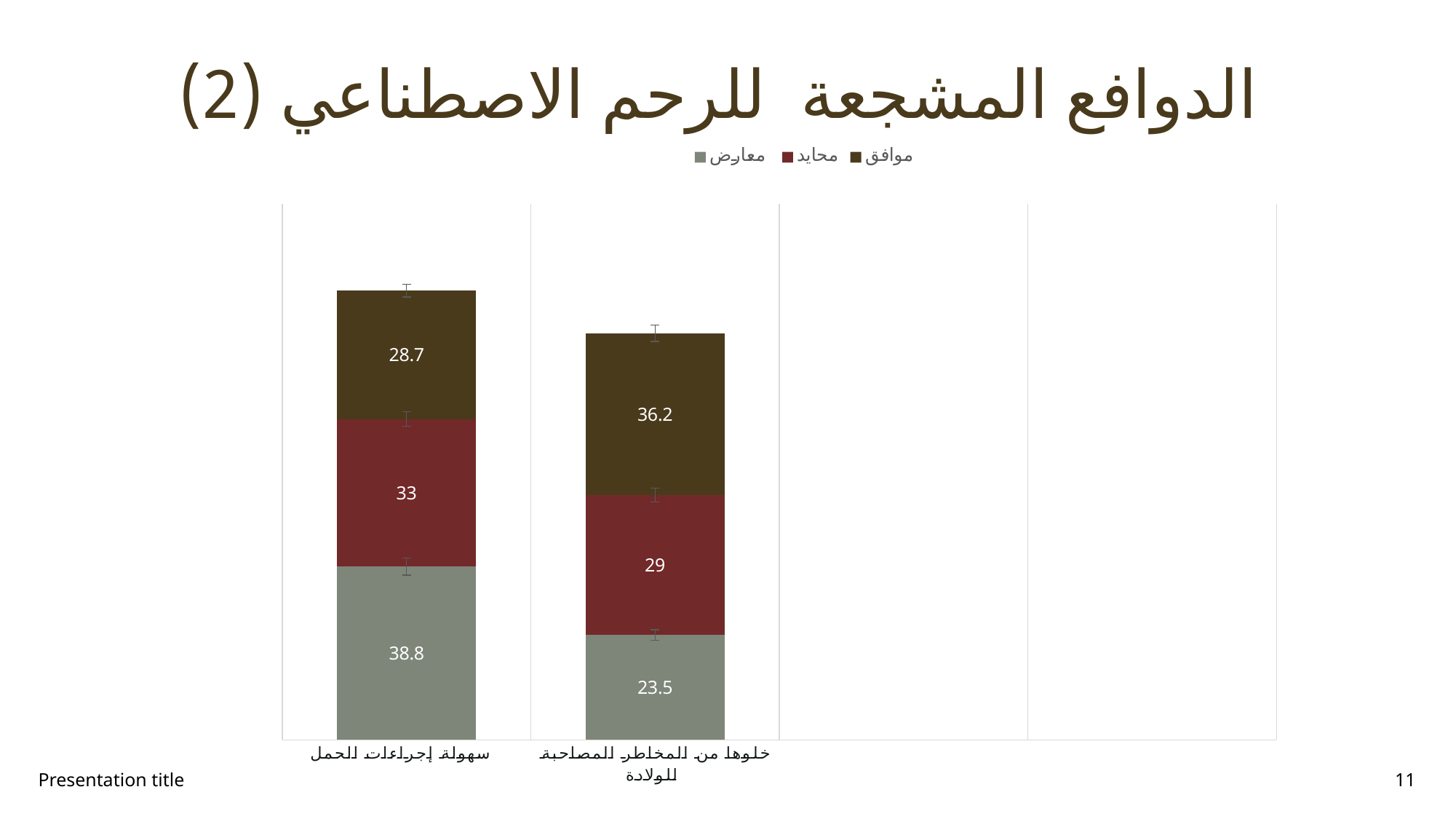
What is the difference between the موافق values for خلوها من المخاطر المصاحبة للولادة and سهولة إجراءات الحمل? 7.5 How many series does the legend list? 3 Which category has the higher value for معارض? سهولة إجراءات الحمل What is the value of موافق for خلوها من المخاطر المصاحبة للولادة? 36.2 What kind of chart is shown on the slide? Stacked bar chart What is the value of معارض for خلوها من المخاطر المصاحبة للولادة? 23.5 What is the value of محايد for سهولة إجراءات الحمل? 33 What is the total of the stacked bar for خلوها من المخاطر المصاحبة للولادة? 88.7 What is the value of موافق for سهولة إجراءات الحمل? 28.7 Which segment is the largest in the bar for سهولة إجراءات الحمل? معارض What is the title of the slide? الدوافع المشجعة للرحم الاصطناعي (2) How many categories are plotted on the x axis? 2